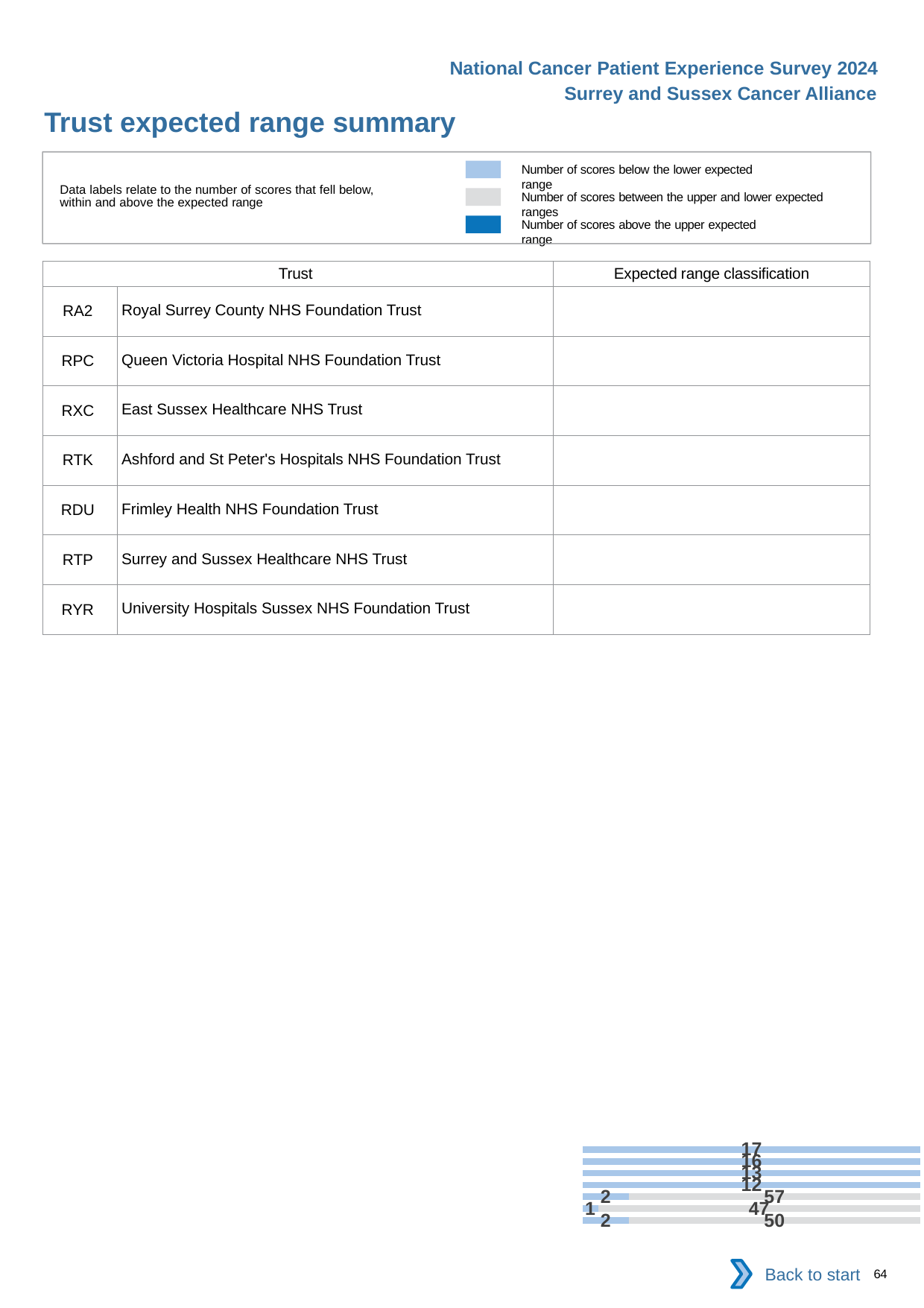
What is the smallest data label value printed on the chart? 1 How many bars are plotted in the chart at the bottom right of the slide? 7 What is the largest data label value printed on the chart? 57 What kind of chart is shown at the bottom right of the slide? bar chart How many series does the legend at the top of the slide list? 3 According to the legend, which colour represents the number of scores below the lower expected range? light blue According to the legend, which colour represents the number of scores above the upper expected range? dark blue